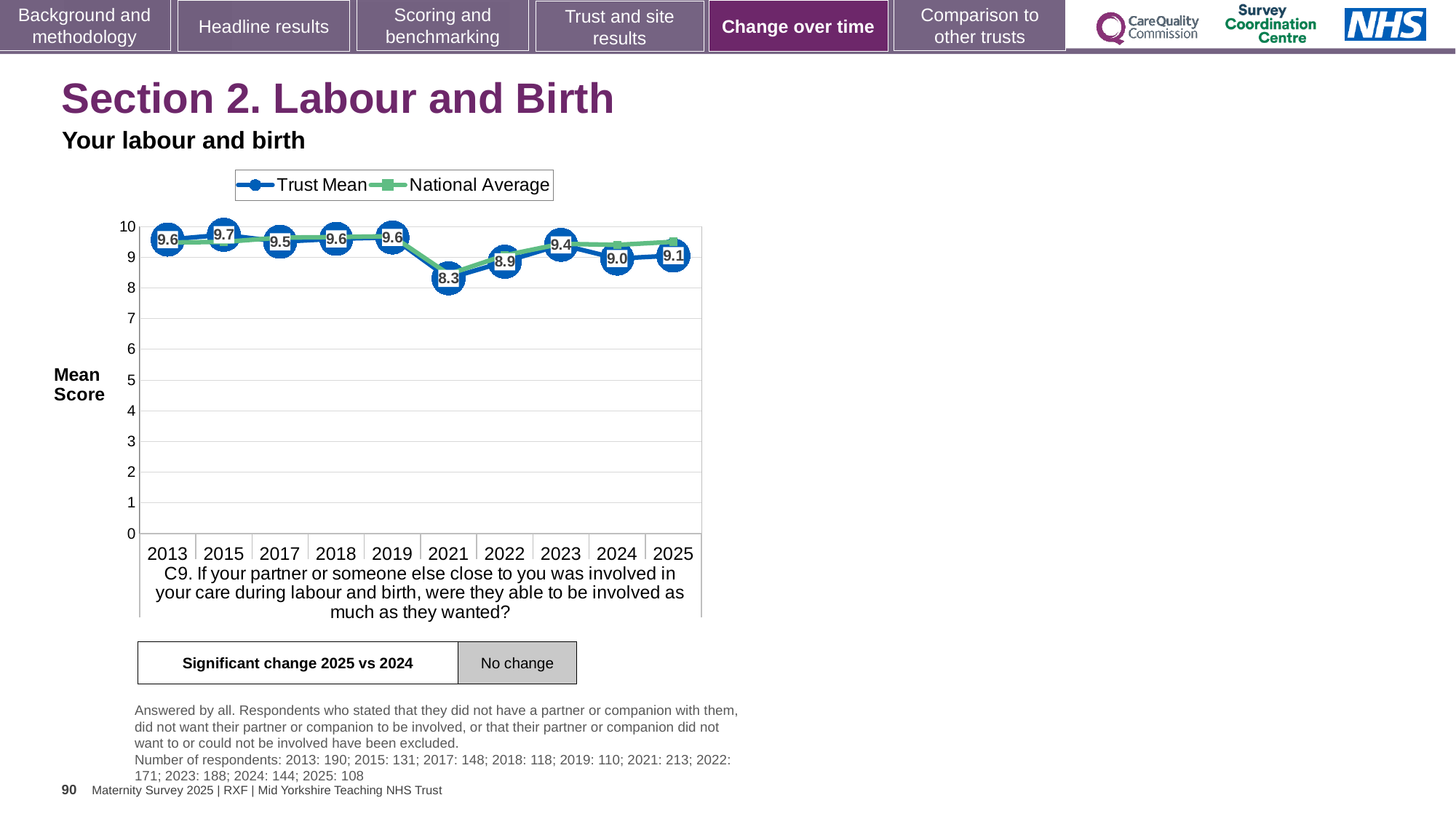
What is the difference between the Trust Mean scores for 2019 and 2021? 1.3 What is the Trust Mean score for 2015? 9.7 What kind of chart is shown on the slide? Line chart How many series does the chart legend list? 2 In which year is the Trust Mean score the highest? 2015 Which year has a higher Trust Mean score, 2023 or 2024? 2023 What is the Trust Mean score for 2021? 8.3 Did the Trust Mean score rise or fall between 2019 and 2021? Fall What is the Trust Mean score for 2025? 9.1 What are the two series named in the chart legend? Trust Mean and National Average In which year is the Trust Mean score the lowest? 2021 How many years are shown on the x axis of the chart? 10